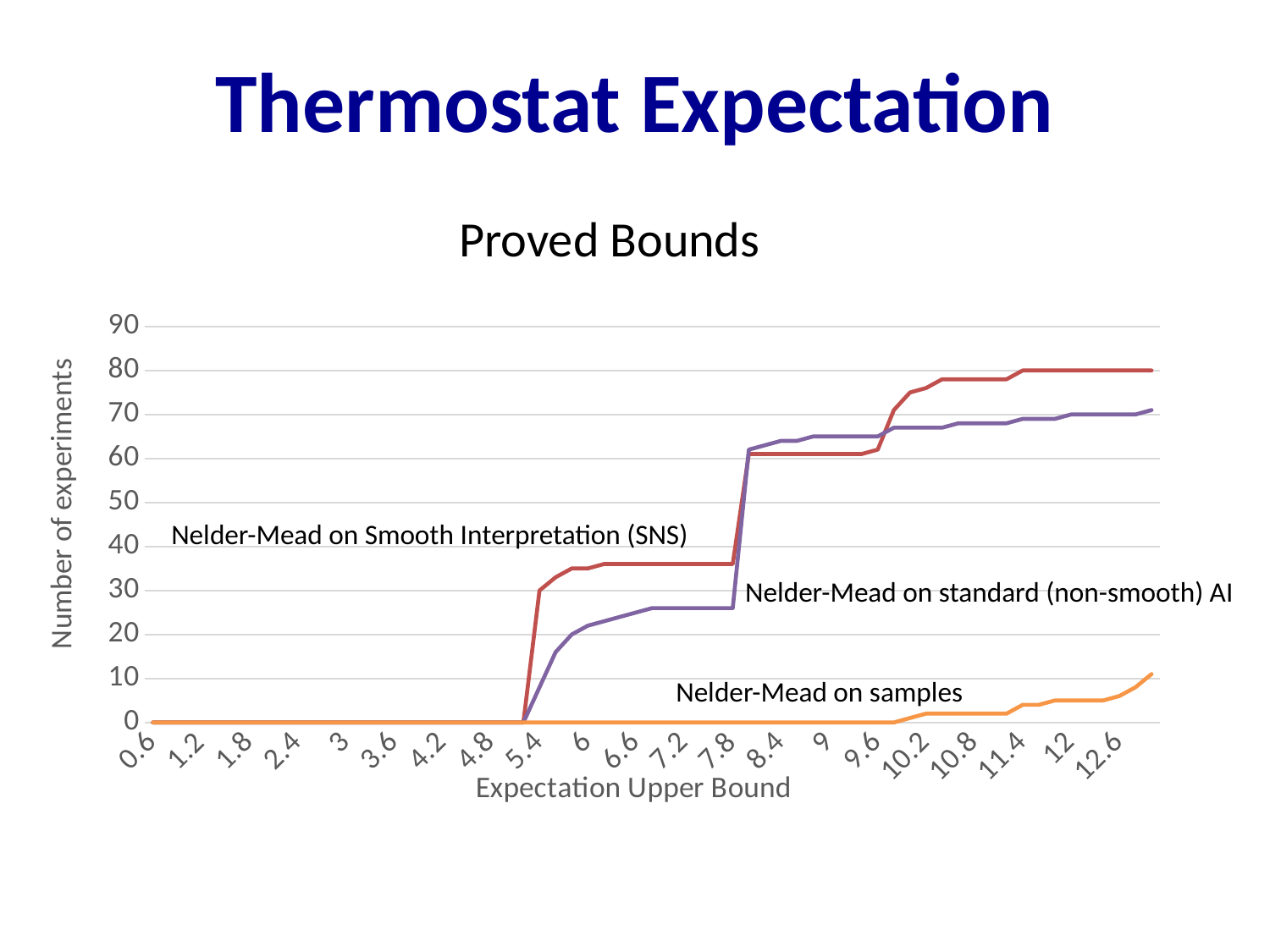
At an expectation upper bound of 12.6, is the value for Nelder-Mead on samples greater or less than 20? less How many series (lines) are plotted on the chart? 3 At an expectation upper bound of 6.6, which series has the higher number of experiments: Nelder-Mead on Smooth Interpretation (SNS) or Nelder-Mead on standard (non-smooth) AI? Nelder-Mead on Smooth Interpretation (SNS) At an expectation upper bound of 9.6, which series has the higher number of experiments: Nelder-Mead on samples or Nelder-Mead on standard (non-smooth) AI? Nelder-Mead on standard (non-smooth) AI What kind of chart is shown on the slide? line chart What is the title of the chart? Proved Bounds Does the number of experiments for Nelder-Mead on Smooth Interpretation (SNS) rise or fall as the expectation upper bound increases? rise What is the label of the x axis? Expectation Upper Bound Which series reaches the highest number of experiments on the chart? Nelder-Mead on Smooth Interpretation (SNS) At an expectation upper bound of 6.6, is the value for Nelder-Mead on standard (non-smooth) AI greater or less than 30? less At an expectation upper bound of 12.6, is the value for Nelder-Mead on Smooth Interpretation (SNS) greater or less than 70? greater Which series has the lowest number of experiments across the chart? Nelder-Mead on samples